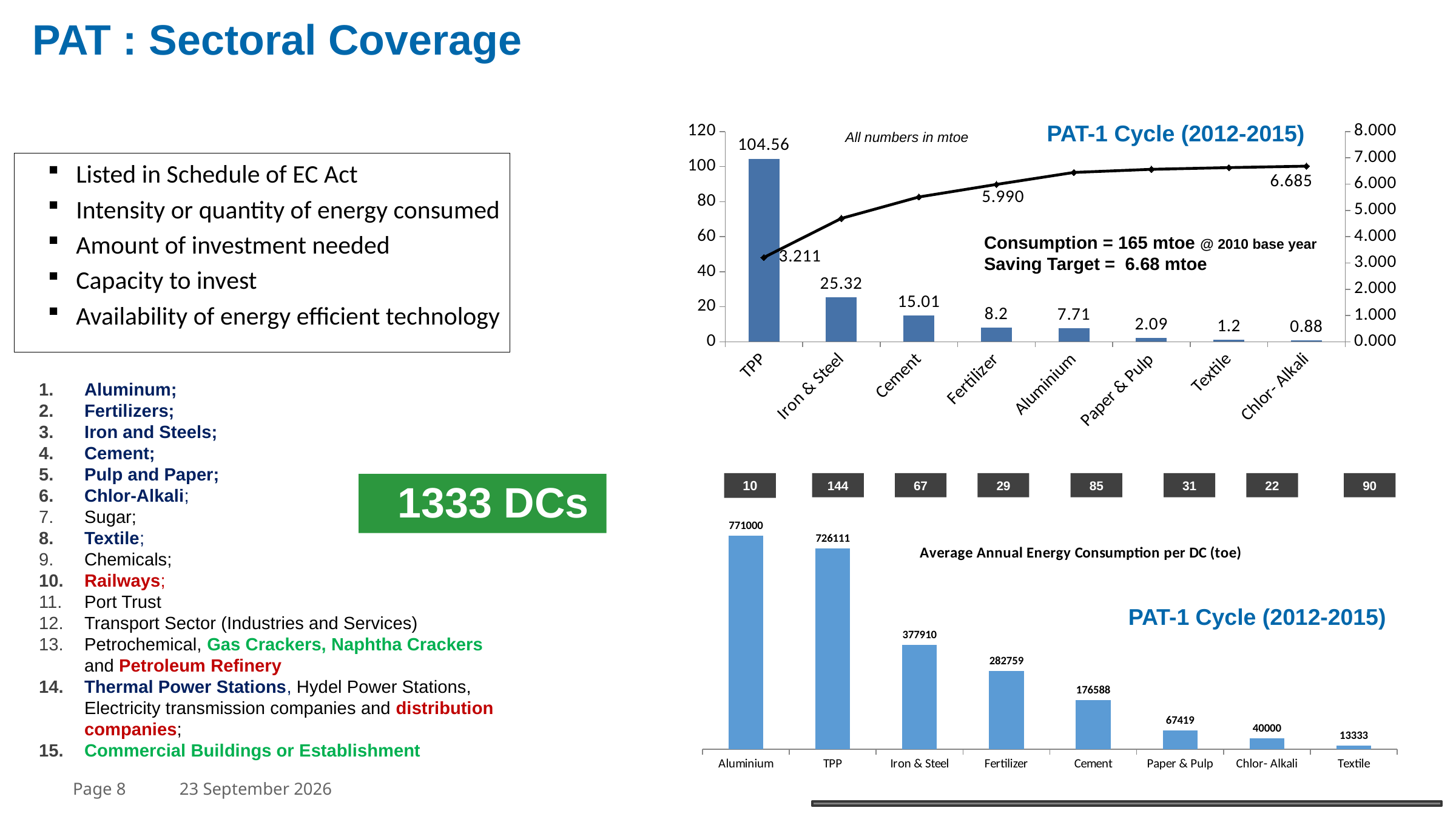
In the top chart (PAT-1 Cycle, all numbers in mtoe), does the line rise or fall from TPP to Chlor- Alkali? rise In the bottom chart (Average Annual Energy Consumption per DC), which is larger, the value for Fertilizer or the value for Cement? Fertilizer In the bottom chart (Average Annual Energy Consumption per DC), what is the value for Iron & Steel? 377910 In the bottom chart (Average Annual Energy Consumption per DC), what is the difference between the values for Aluminium and TPP? 44889 In the bottom chart (Average Annual Energy Consumption per DC), which sector has the highest value? Aluminium In the top chart (PAT-1 Cycle, all numbers in mtoe), how many sectors are shown on the x axis? 8 In the top chart (PAT-1 Cycle, all numbers in mtoe), which sector has the lowest bar? Chlor- Alkali What kind of chart is the bottom chart (Average Annual Energy Consumption per DC)? bar chart In the top chart (PAT-1 Cycle, all numbers in mtoe), what is the difference between the bars for Iron & Steel and Cement? 10.31 In the top chart (PAT-1 Cycle, all numbers in mtoe), what is the last labelled value on the line, at Chlor- Alkali? 6.685 In the top chart (PAT-1 Cycle, all numbers in mtoe), what is the value of the bar for Cement? 15.01 In the top chart (PAT-1 Cycle, all numbers in mtoe), what is the value of the bar for TPP? 104.56